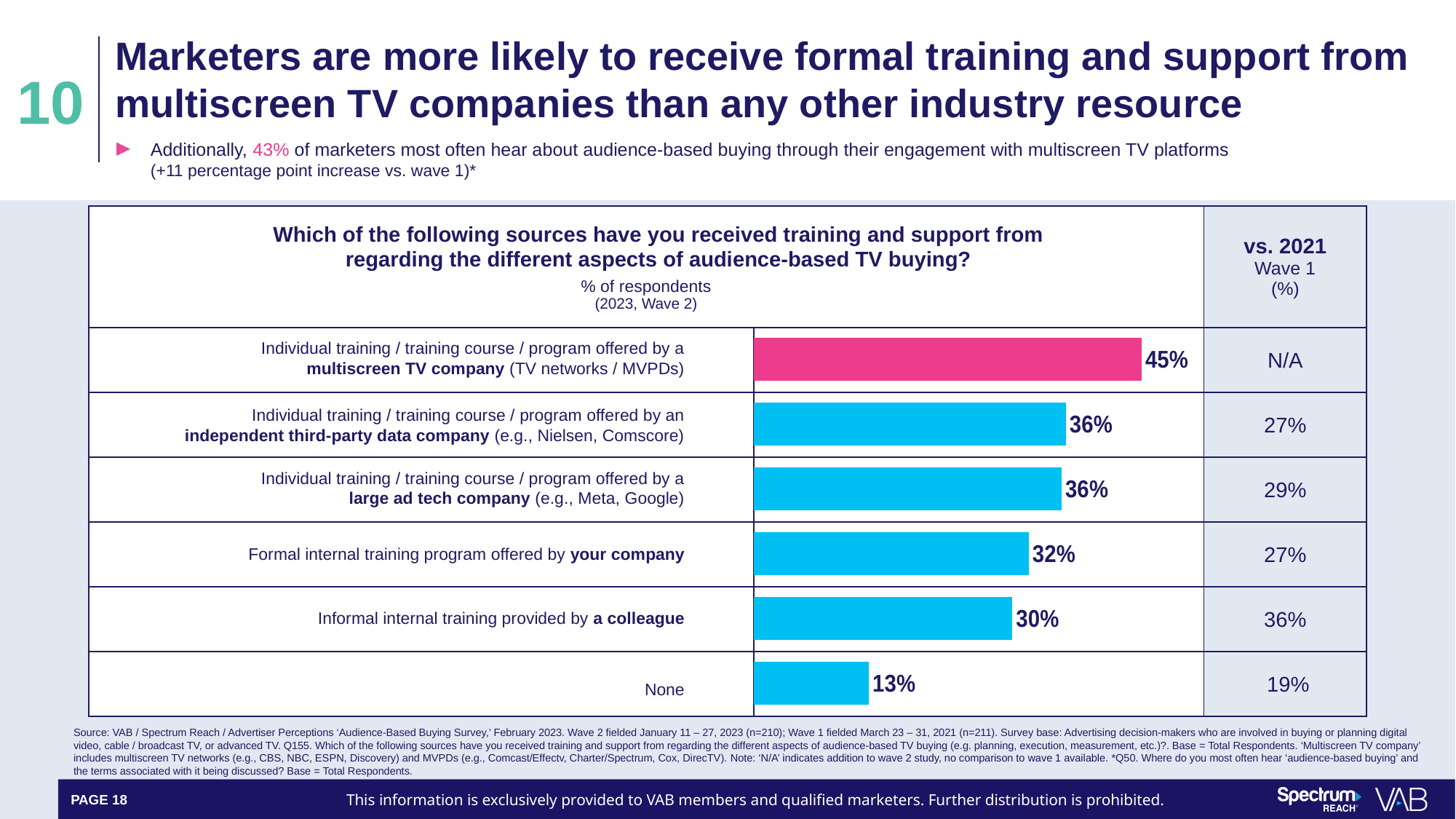
Which source has the highest percentage of respondents? Individual training / training course / program offered by a multiscreen TV company What percentage of respondents received informal internal training provided by a colleague? 30% What is the difference in percentage points between the multiscreen TV company bar and the 'your company' formal internal training bar? 13 What percentage of respondents received training from a large ad tech company? 36% What was the 2021 Wave 1 value for informal internal training provided by a colleague? 36% Which is larger: the value for formal internal training offered by your company or informal internal training provided by a colleague? Formal internal training program offered by your company What percentage of respondents received training from a multiscreen TV company? 45% How many categories are shown in the bar chart? 6 Which category has the lowest percentage of respondents? None What kind of chart is used to show the % of respondents? Bar chart What percentage of respondents selected 'None'? 13% Which bar is coloured differently (pink) from the others? Individual training / training course / program offered by a multiscreen TV company